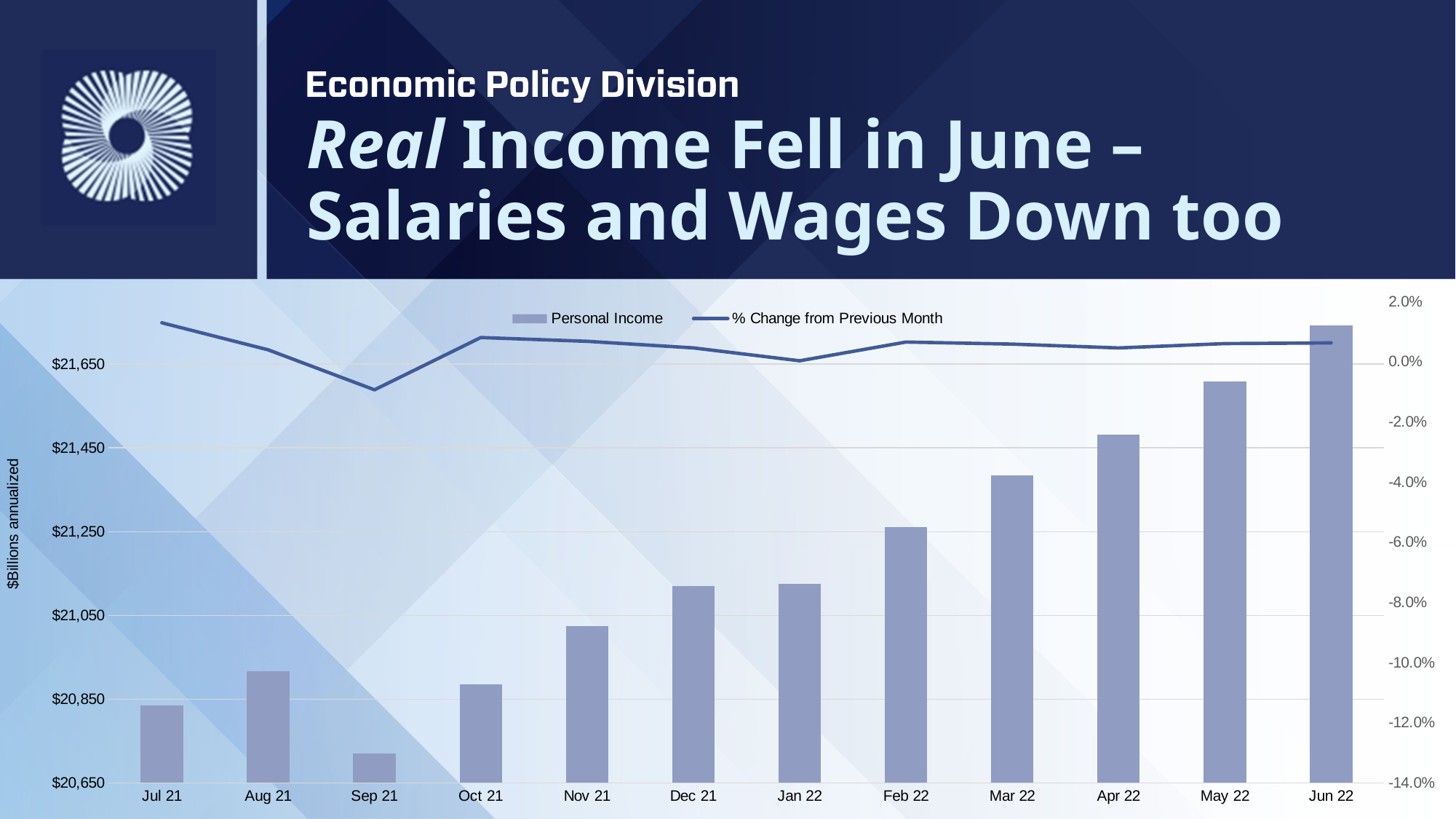
Is the Personal Income value for Jun 22 greater or less than $21,650? greater How many series does the chart legend list? 2 Is the Personal Income value for Mar 22 greater or less than $21,450? less What is the label on the left vertical axis of the chart? $Billions annualized Which month has the lowest Personal Income bar? Sep 21 Is the Personal Income value for Sep 21 greater or less than $20,850? less Which month has the lowest value on the % Change from Previous Month line? Sep 21 Do the Personal Income bars generally rise or fall from Oct 21 to Jun 22? rise How many months are shown on the x axis of the chart? 12 Which is larger, the Personal Income bar for Aug 21 or for Jul 21? Aug 21 What kind of chart is shown on the slide? Combined bar and line chart Which month has the highest Personal Income bar? Jun 22